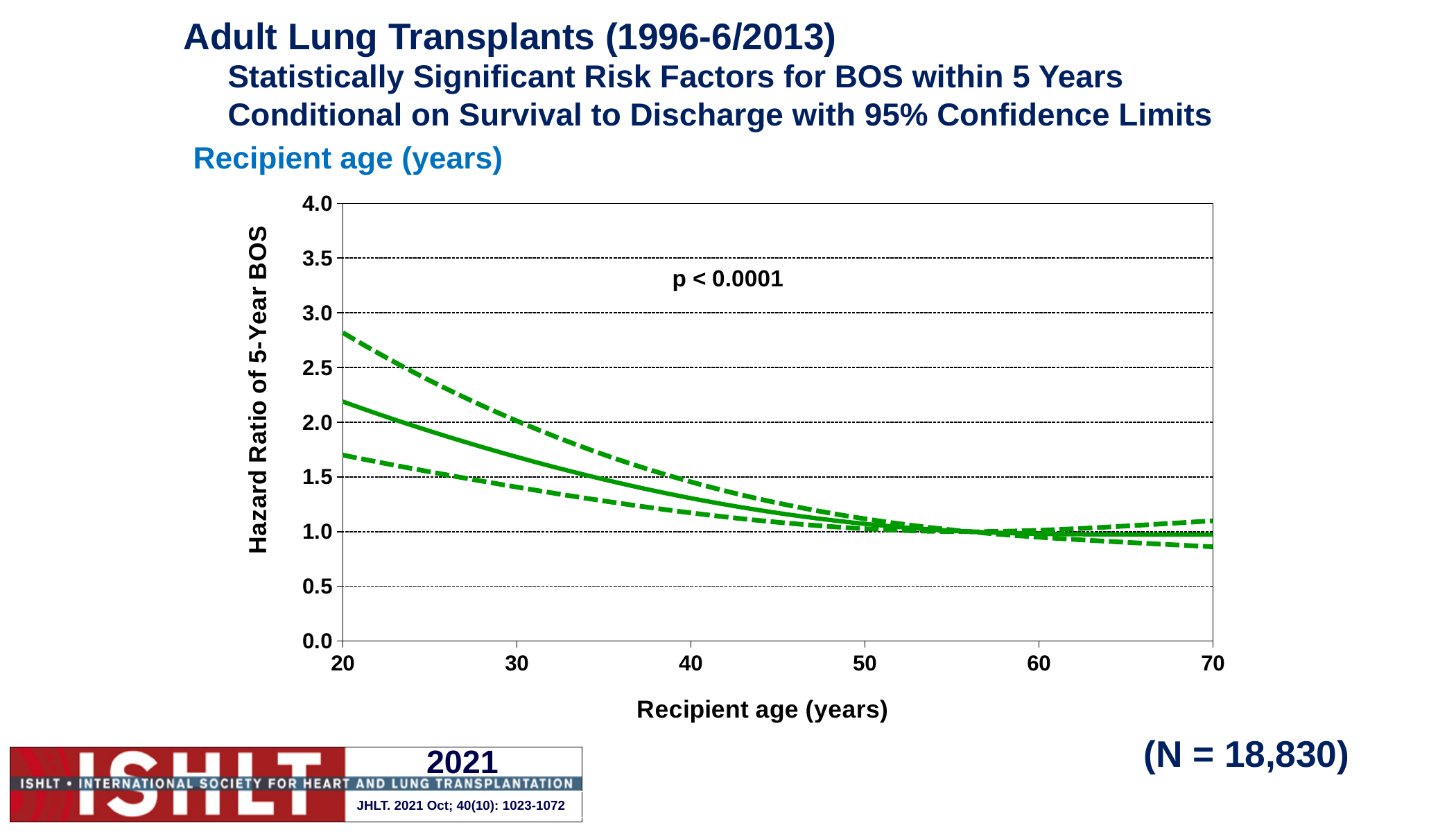
What kind of chart is shown on the slide? Line chart How many lines are plotted on the chart? 3 What p-value is printed on the chart? p < 0.0001 Which is larger, the hazard ratio (solid line) at recipient age 20 or at recipient age 60? Age 20 Is the hazard ratio (solid line) at recipient age 40 greater or less than 1.5? less Is the lower confidence limit (lower dashed line) at recipient age 20 greater or less than 1.5? greater Is the hazard ratio (solid line) at recipient age 30 greater or less than 2.0? less At which recipient age shown on the x axis is the hazard ratio (solid line) highest? 20 Does the hazard ratio (solid line) rise or fall as recipient age increases from 20 to 50 years? Fall What is the label of the y axis? Hazard Ratio of 5-Year BOS